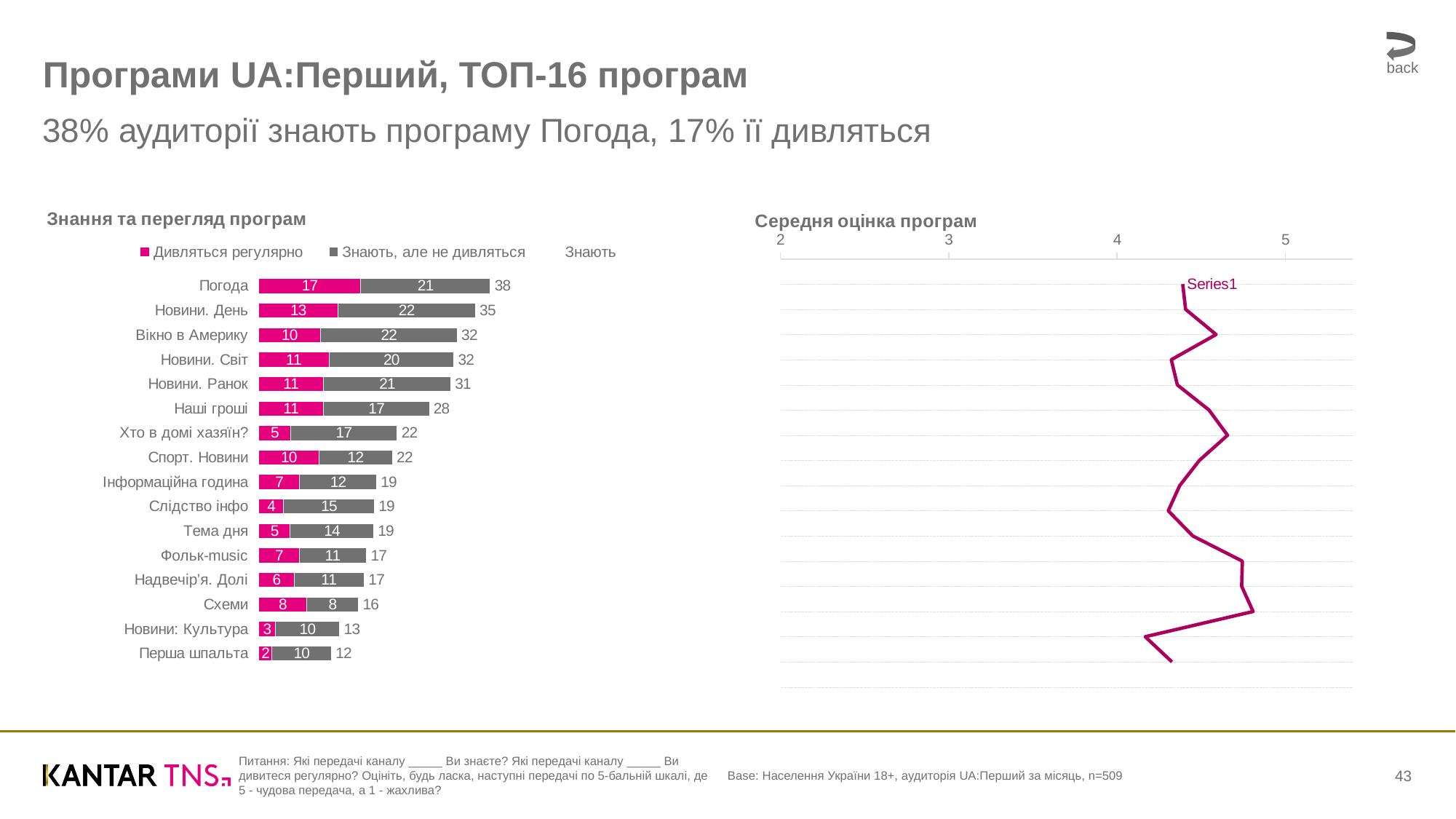
In the chart 'Знання та перегляд програм', what is the sum of 'Дивляться регулярно' and 'Знають, але не дивляться' for Схеми? 16 In the chart 'Знання та перегляд програм', what is the value of 'Дивляться регулярно' for Погода? 17 In the chart 'Знання та перегляд програм', which has a larger 'Дивляться регулярно' value: Спорт. Новини or Хто в домі хазяїн? Спорт. Новини In the chart 'Знання та перегляд програм', what is the 'Знають' total for Наші гроші? 28 In the chart 'Знання та перегляд програм', what is the difference between the 'Знають' totals for Погода and Новини. День? 3 In the chart 'Знання та перегляд програм', which program has the lowest 'Дивляться регулярно' value? Перша шпальта In the chart 'Знання та перегляд програм', what is the value of 'Знають, але не дивляться' for Новини. День? 22 How many entries does the legend of the chart 'Знання та перегляд програм' list? 3 What kind of chart is 'Знання та перегляд програм'? Stacked bar chart How many programs are listed in the chart 'Знання та перегляд програм'? 16 What kind of chart is 'Середня оцінка програм'? Line chart In the chart 'Знання та перегляд програм', which program has the highest 'Знають' total? Погода